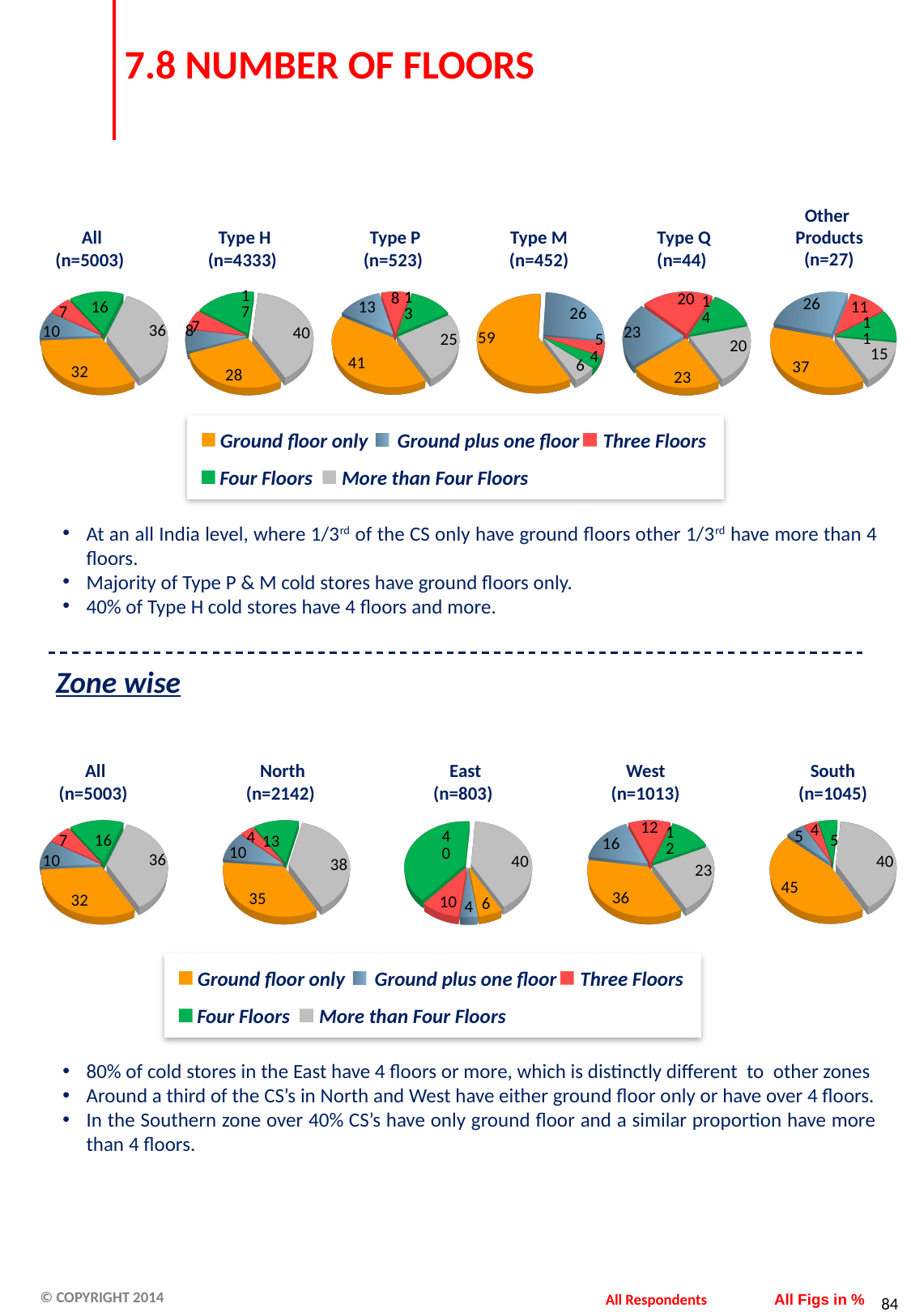
In the Zone wise East (n=803) pie chart, what is the value for More than Four Floors? 40 In the top row of pie charts, what percentage of All (n=5003) cold stores have ground floor only? 32 In the Type H (n=4333) pie chart, what is the value for More than Four Floors? 40 In the Zone wise North (n=2142) pie chart, which category has the smallest share? Three Floors In the Type M (n=452) pie chart, which category has the largest share? Ground floor only In the Zone wise West (n=1013) pie chart, what is the difference between Ground floor only and More than Four Floors? 13 What kind of chart is used in the Zone wise section? Pie chart In the Type M (n=452) pie chart, what is the value for Ground floor only? 59 How many series does the legend list for the pie charts? 5 In the Type P (n=523) pie chart, what is the difference between Ground floor only and More than Four Floors? 16 In the Type M (n=452) pie chart, which is larger: Ground plus one floor or More than Four Floors? Ground plus one floor In the Zone wise South (n=1045) pie chart, what is the value for Ground floor only? 45